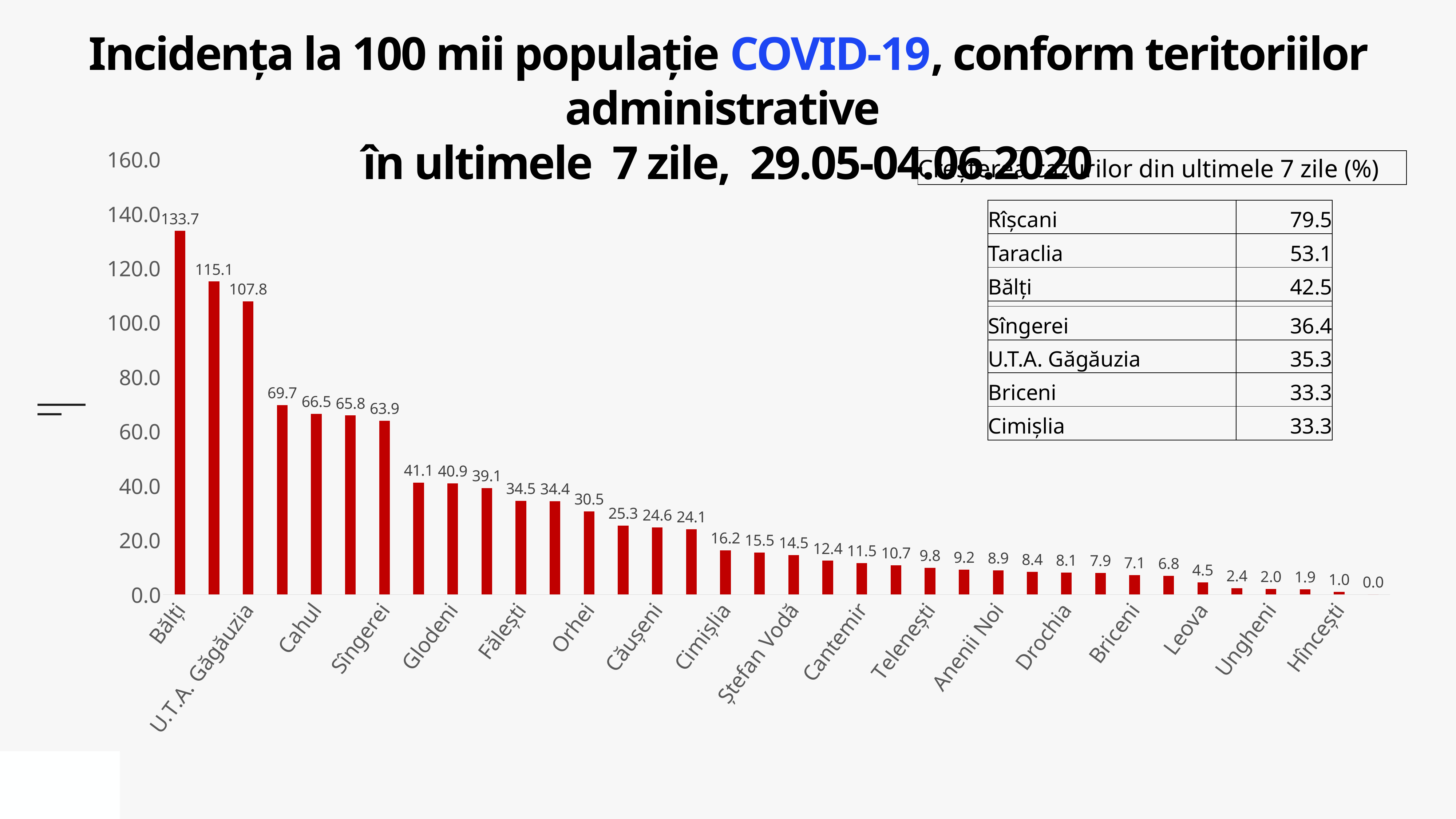
What colour are the bars in the chart? red What kind of chart is shown on the slide? bar chart How many bars are plotted in the chart? 36 What is the incidence value shown for Bălți? 133.7 What period does the chart title say the data covers? 29.05-04.06.2020 Do the values rise or fall from left to right along the x axis? fall Which territory has the highest incidence in the chart? Bălți What is the lowest value shown on any bar in the chart? 0.0 What is the difference between the highest bar value (133.7) and the lowest bar value (0.0)? 133.7 Is the value for Bălți greater or less than 120? greater How many bars have a value above 100? 3 What is the highest value shown on any bar in the chart? 133.7